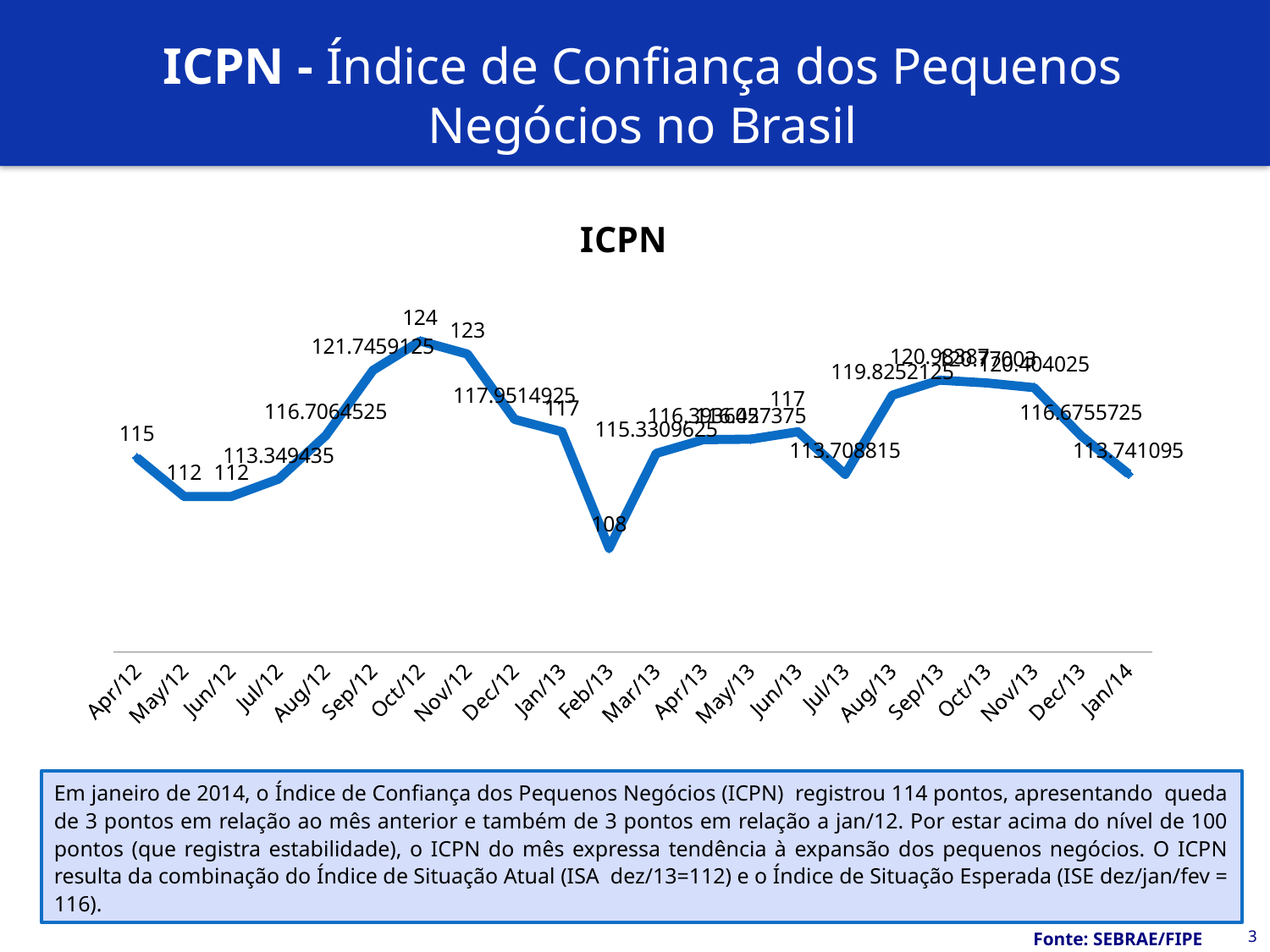
What is the ICPN value for Oct/12? 124 Which month has the highest ICPN value? Oct/12 Which month has the lowest ICPN value? Feb/13 What is the ICPN value for Apr/12? 115 What is the ICPN value for Dec/13? 116.6755725 How many months are plotted on the ICPN chart? 22 Does the ICPN value rise or fall from Oct/12 to Feb/13? Fall What is the difference between the ICPN values for Oct/12 and Feb/13? 16 What kind of chart is shown on the slide? Line chart Which is larger, the ICPN value for Nov/12 or for Jan/13? Nov/12 What is the ICPN value for Feb/13? 108 What is the ICPN value for Jan/14? 113.741095